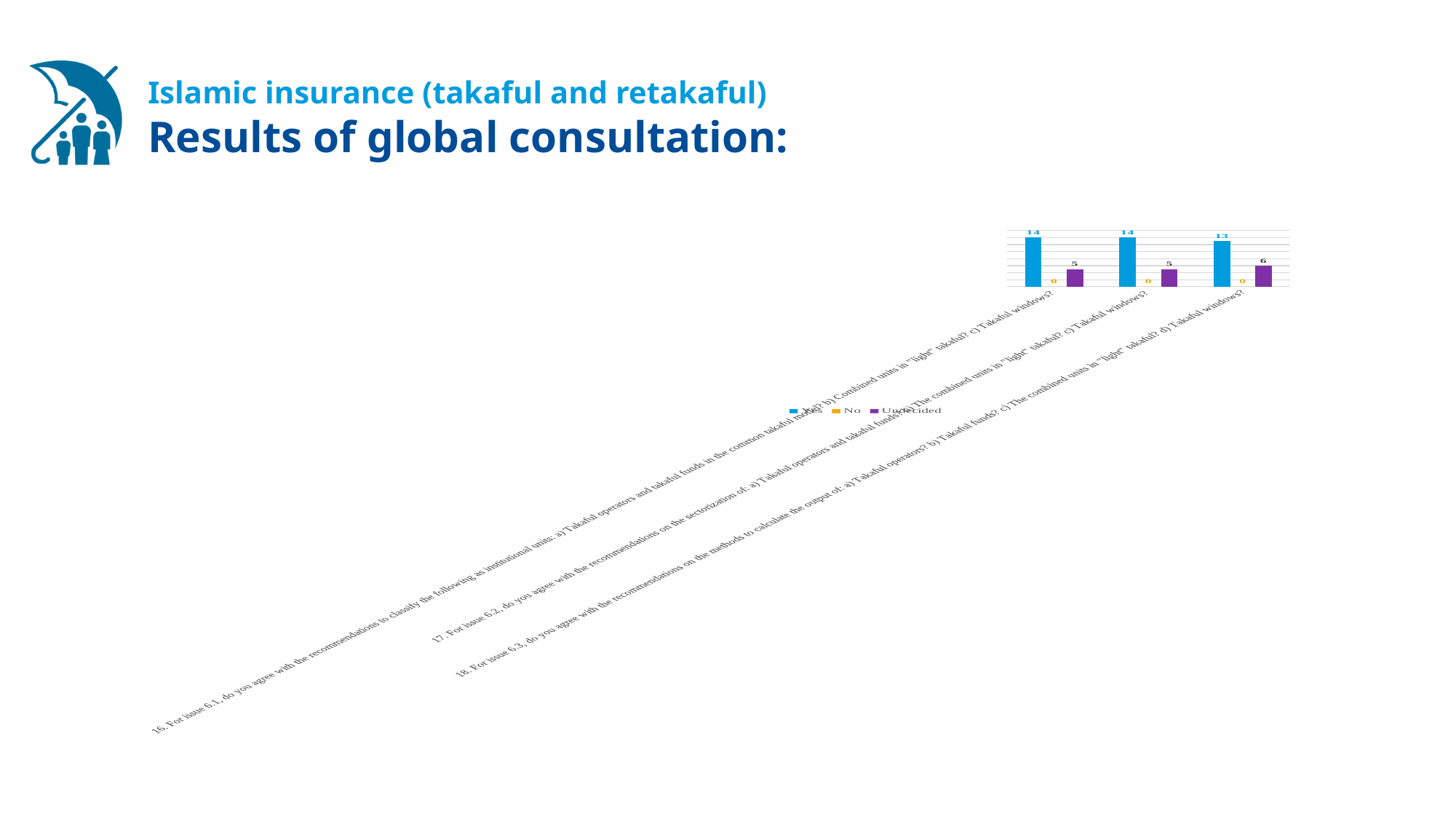
Which question has the highest 'Undecided' value? 18. For issue 6.3 How many question categories are plotted on the x axis? 3 How many series does the legend list? 3 What kind of chart is shown on the slide? bar chart Which question has the lowest 'Yes' value? 18. For issue 6.3 What is the 'Undecided' value for question 18 (issue 6.3)? 6 What is the 'Yes' value for question 18 (issue 6.3)? 13 What is the 'No' value for question 17 (issue 6.2)? 0 What is the difference between the 'Yes' and 'Undecided' values for question 17 (issue 6.2)? 9 Is the 'Yes' value for question 16 (issue 6.1) larger or smaller than the 'Yes' value for question 18 (issue 6.3)? larger What are the three legend entries of the chart? Yes, No, Undecided What is the 'Yes' value for question 16 (issue 6.1)? 14